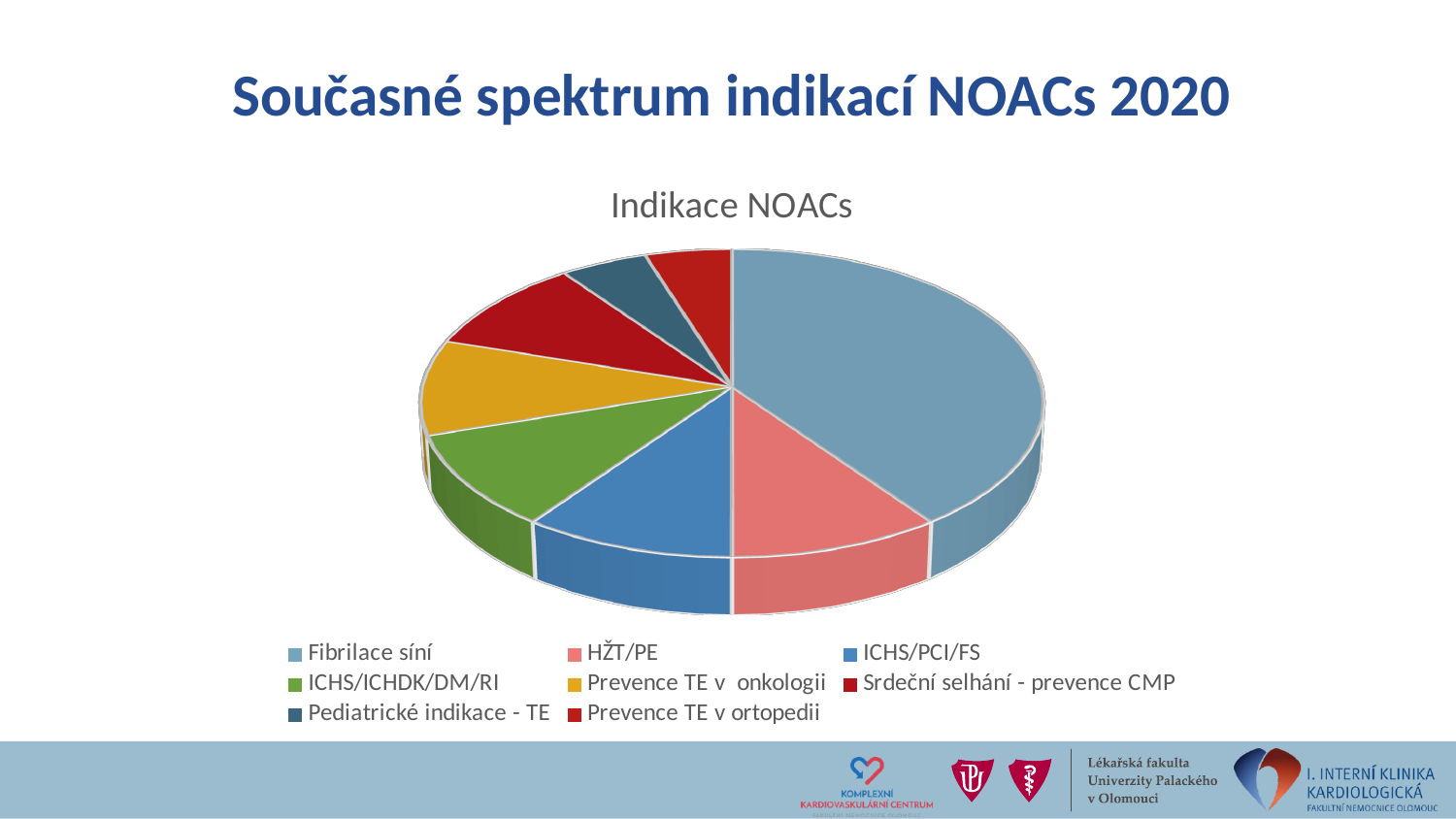
What kind of chart is shown on the slide? Pie chart How many slices does the pie chart have? 8 What colour is the Fibrilace síní slice? Light blue Which slice is larger, ICHS/PCI/FS or Prevence TE v ortopedii? ICHS/PCI/FS Which slice is larger, Srdeční selhání - prevence CMP or Pediatrické indikace - TE? Srdeční selhání - prevence CMP Which slice is larger, HŽT/PE or Prevence TE v ortopedii? HŽT/PE What is the title of the chart? Indikace NOACs Which category has the largest slice of the pie? Fibrilace síní How many entries does the legend list? 8